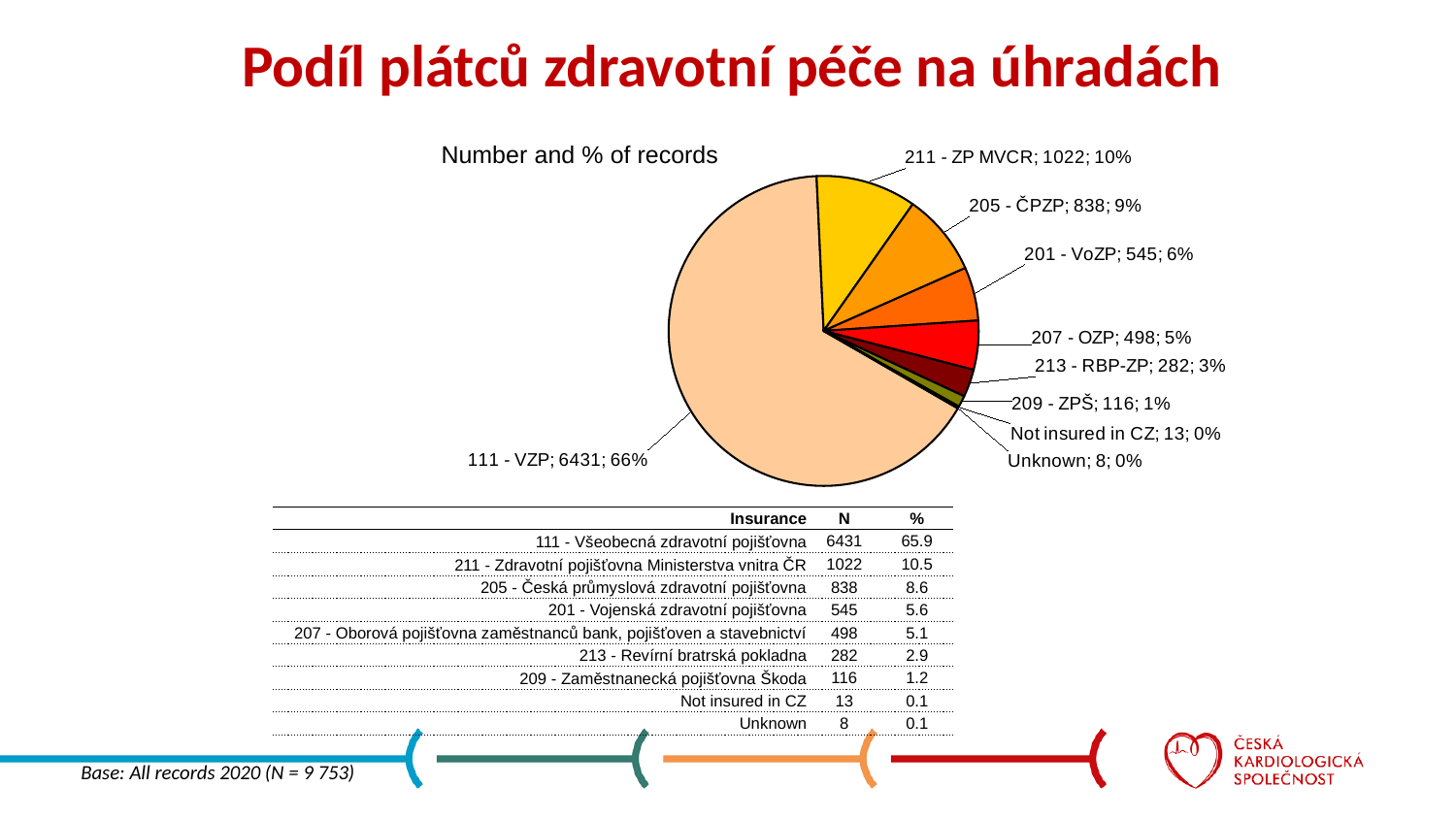
What share of the pie does 211 - ZP MVCR represent? 10% What percentage share is shown for 207 - OZP? 5% What is the number of records for 205 - ČPZP? 838 What is the number of records for Not insured in CZ? 13 Which has more records, 213 - RBP-ZP or 209 - ZPŠ? 213 - RBP-ZP What is the number of records for 111 - VZP in the pie chart? 6431 Which slice of the pie chart is the largest? 111 - VZP How many slices does the pie chart have? 9 What is the difference in number of records between 201 - VoZP and 207 - OZP? 47 What is the title of the chart? Number and % of records What kind of chart is shown on the slide? pie chart Which slice of the pie chart is the smallest? Unknown